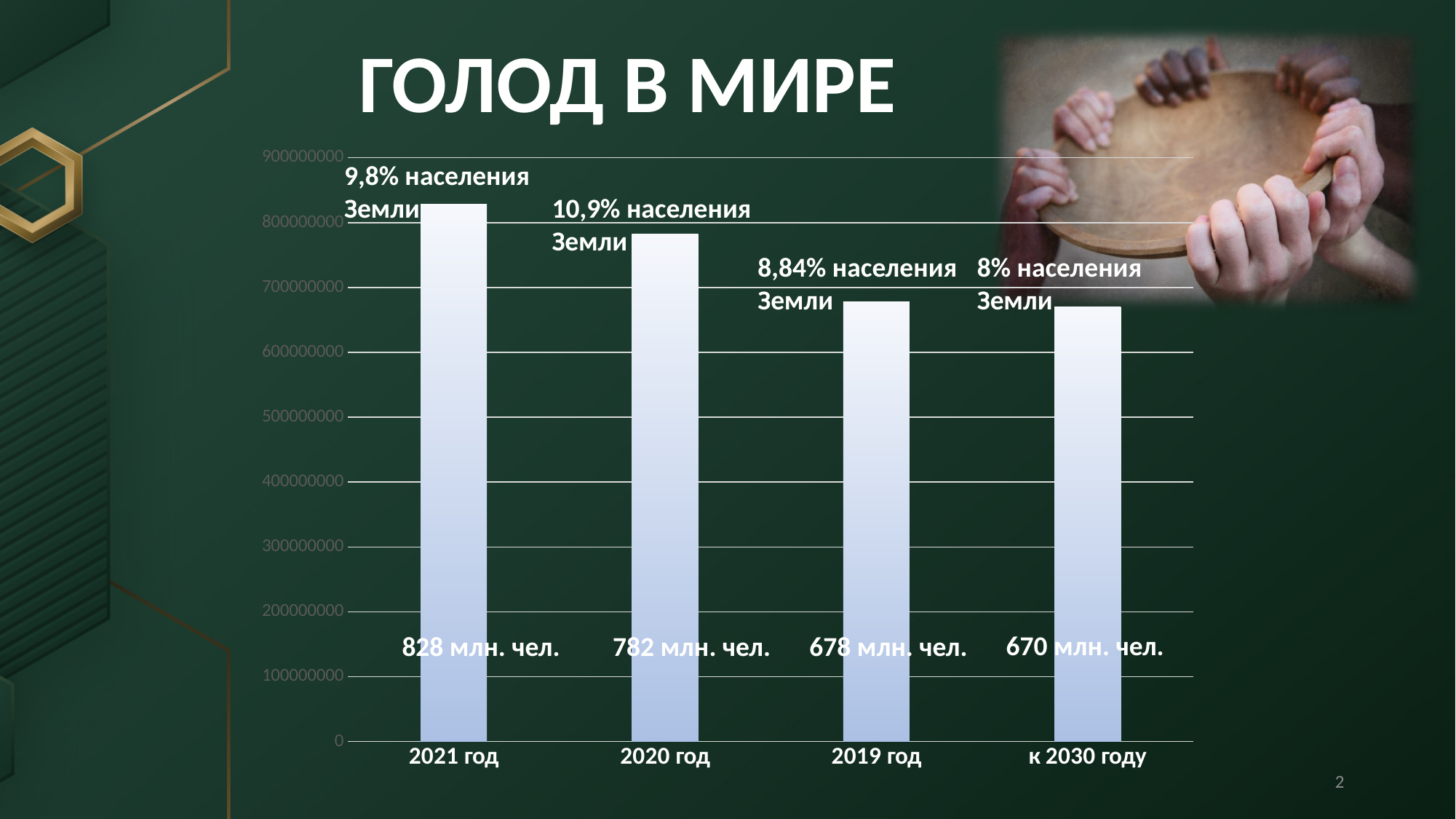
What value is shown for 2020 год? 782 млн. чел. What value is shown for 2021 год? 828 млн. чел. How many categories are shown on the x axis? 4 What value is shown for к 2030 году? 670 млн. чел. Is the value for 2019 год greater or less than 700000000? less Which category has the lowest value? к 2030 году What is the title of the slide? ГОЛОД В МИРЕ Which is larger, the value for 2019 год or the value for к 2030 году? 2019 год What kind of chart is shown on the slide? bar chart What is the difference between the values for 2021 год and 2020 год? 46 млн. чел. What share of the Earth's population is given for 2019 год? 8,84% населения Земли Which category has the highest value? 2021 год